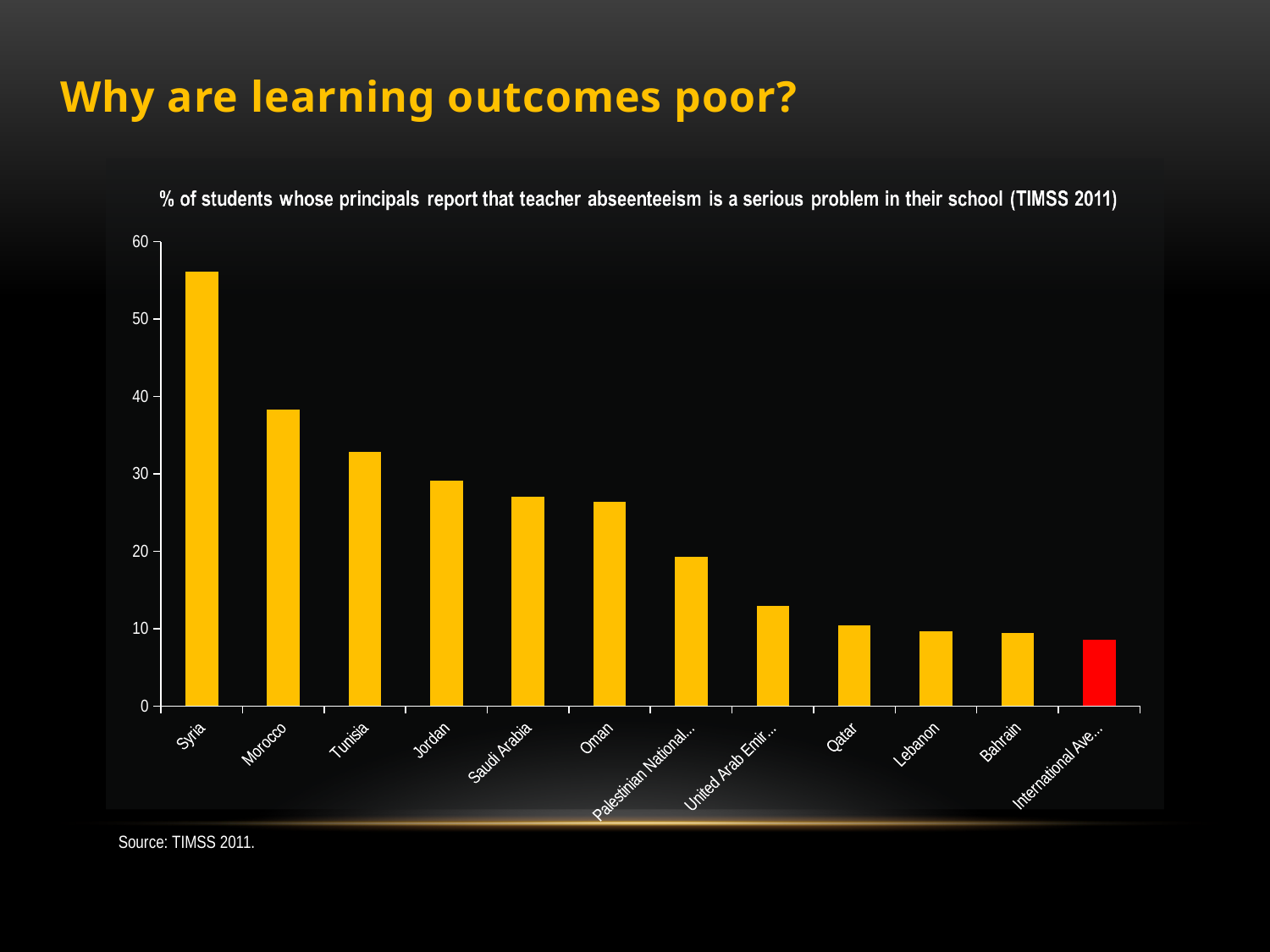
Is the value for Syria greater or less than 50? greater How many bars are plotted in the chart? 12 Which has a larger value, Oman or Qatar? Oman Is the value for Morocco greater or less than 40? less Which has a larger value, Morocco or Tunisia? Morocco Is the value for Oman greater or less than 20? greater Which bar is coloured red rather than yellow? International Average Do the values rise or fall moving from left to right along the x axis? Fall Which category has the highest value in the chart? Syria What kind of chart is shown on the slide? Bar chart